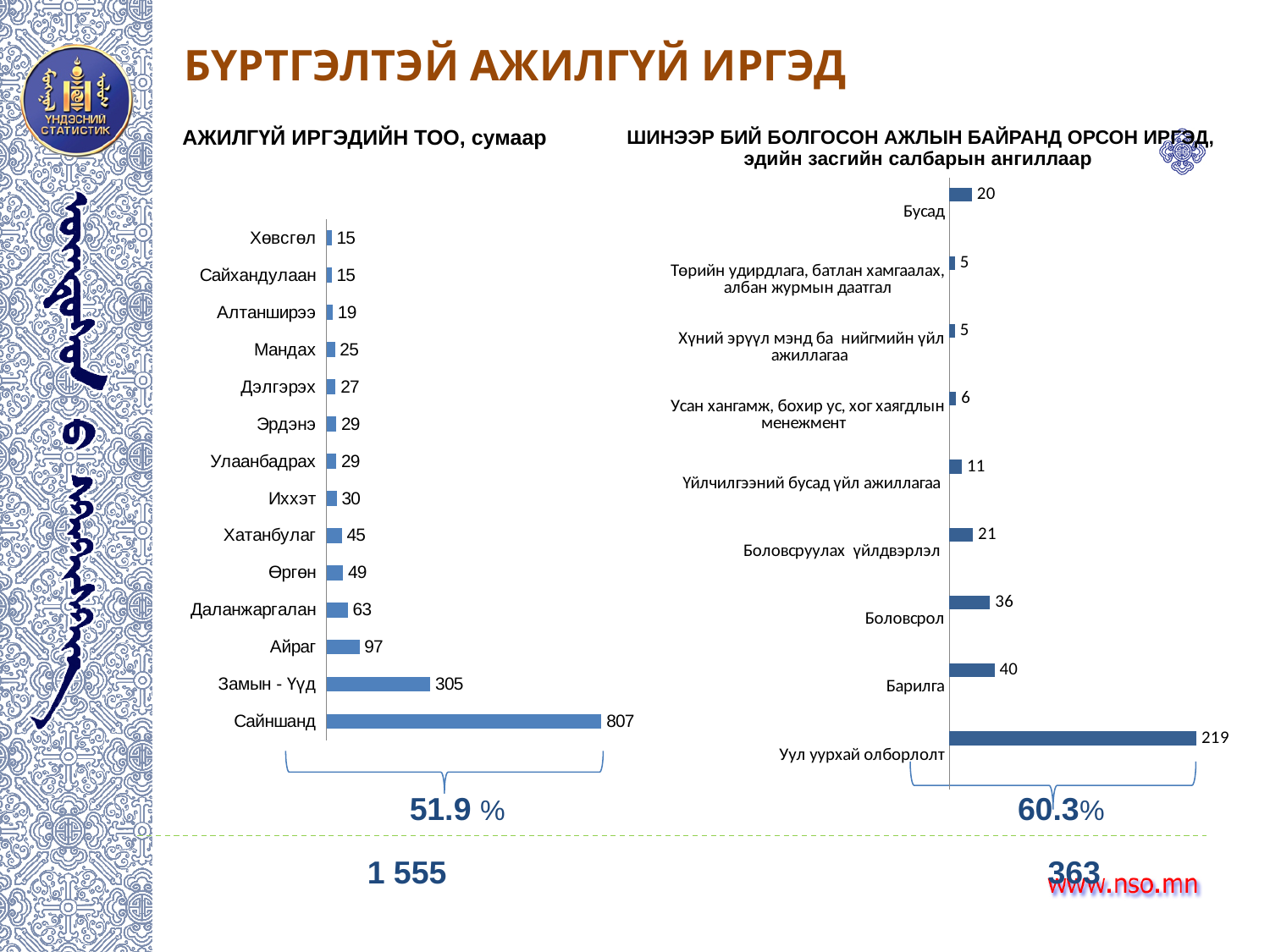
In the right chart (ШИНЭЭР БИЙ БОЛГОСОН АЖЛЫН БАЙРАНД ОРСОН ИРГЭД), what is the value for Уул уурхай олборлолт? 219 In the left chart (АЖИЛГҮЙ ИРГЭДИЙН ТОО, сумаар), what is the value for Сайншанд? 807 In the left chart (АЖИЛГҮЙ ИРГЭДИЙН ТОО, сумаар), what is the value for Айраг? 97 In the right chart (ШИНЭЭР БИЙ БОЛГОСОН АЖЛЫН БАЙРАНД ОРСОН ИРГЭД), what is the difference between Барилга and Боловсруулах үйлдвэрлэл? 19 In the left chart (АЖИЛГҮЙ ИРГЭДИЙН ТОО, сумаар), which is larger, Хатанбулаг or Өргөн? Өргөн What type of chart is the left chart (АЖИЛГҮЙ ИРГЭДИЙН ТОО, сумаар)? Bar chart In the right chart (ШИНЭЭР БИЙ БОЛГОСОН АЖЛЫН БАЙРАНД ОРСОН ИРГЭД), what is the value for Боловсрол? 36 In the left chart (АЖИЛГҮЙ ИРГЭДИЙН ТОО, сумаар), which category has the highest value? Сайншанд How many categories are shown in the left chart (АЖИЛГҮЙ ИРГЭДИЙН ТОО, сумаар)? 14 How many categories are shown in the right chart (ШИНЭЭР БИЙ БОЛГОСОН АЖЛЫН БАЙРАНД ОРСОН ИРГЭД)? 9 In the left chart (АЖИЛГҮЙ ИРГЭДИЙН ТОО, сумаар), what is the difference between Замын - Үүд and Даланжаргалан? 242 In the right chart (ШИНЭЭР БИЙ БОЛГОСОН АЖЛЫН БАЙРАНД ОРСОН ИРГЭД), which is larger, Бусад or Үйлчилгээний бусад үйл ажиллагаа? Бусад